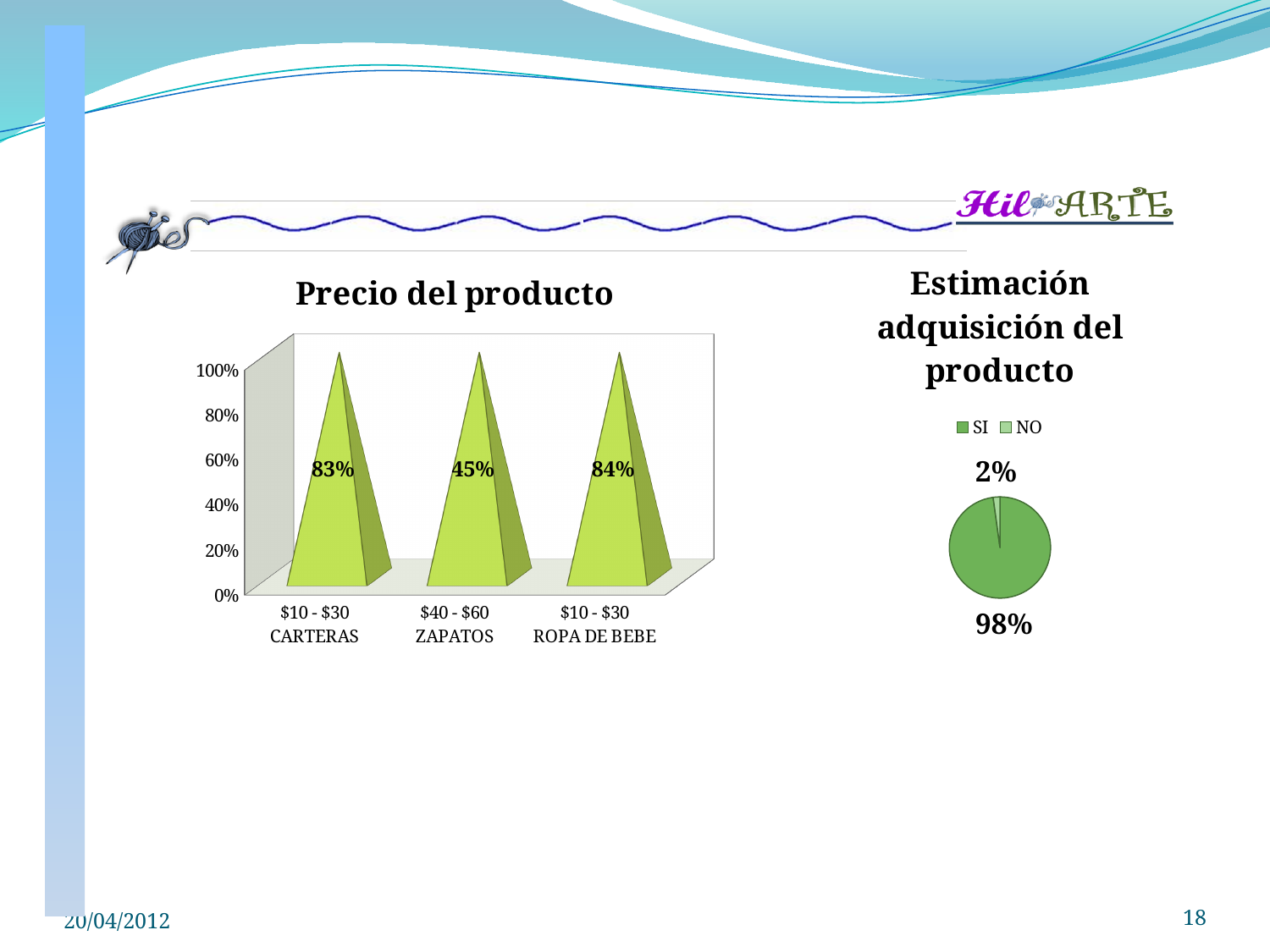
In the 'Precio del producto' chart, what is the value for $10 - $30 ROPA DE BEBE? 84% In the 'Precio del producto' chart, what is the value for $40 - $60 ZAPATOS? 45% How many categories are shown in the 'Precio del producto' chart? 3 In the 'Precio del producto' chart, which category has the highest value? $10 - $30 ROPA DE BEBE In the 'Precio del producto' chart, which is larger, the value for CARTERAS or the value for ZAPATOS? CARTERAS In the 'Precio del producto' chart, what is the difference between the values for CARTERAS and ZAPATOS? 38% How many entries does the legend of the 'Estimación adquisición del producto' chart list? 2 In the 'Estimación adquisición del producto' chart, what is the difference between the SI and NO shares? 96% In the 'Estimación adquisición del producto' chart, what share does SI have? 98% In the 'Precio del producto' chart, which category has the lowest value? $40 - $60 ZAPATOS In the 'Precio del producto' chart, what is the value for $10 - $30 CARTERAS? 83% What kind of chart is 'Precio del producto'? Bar chart